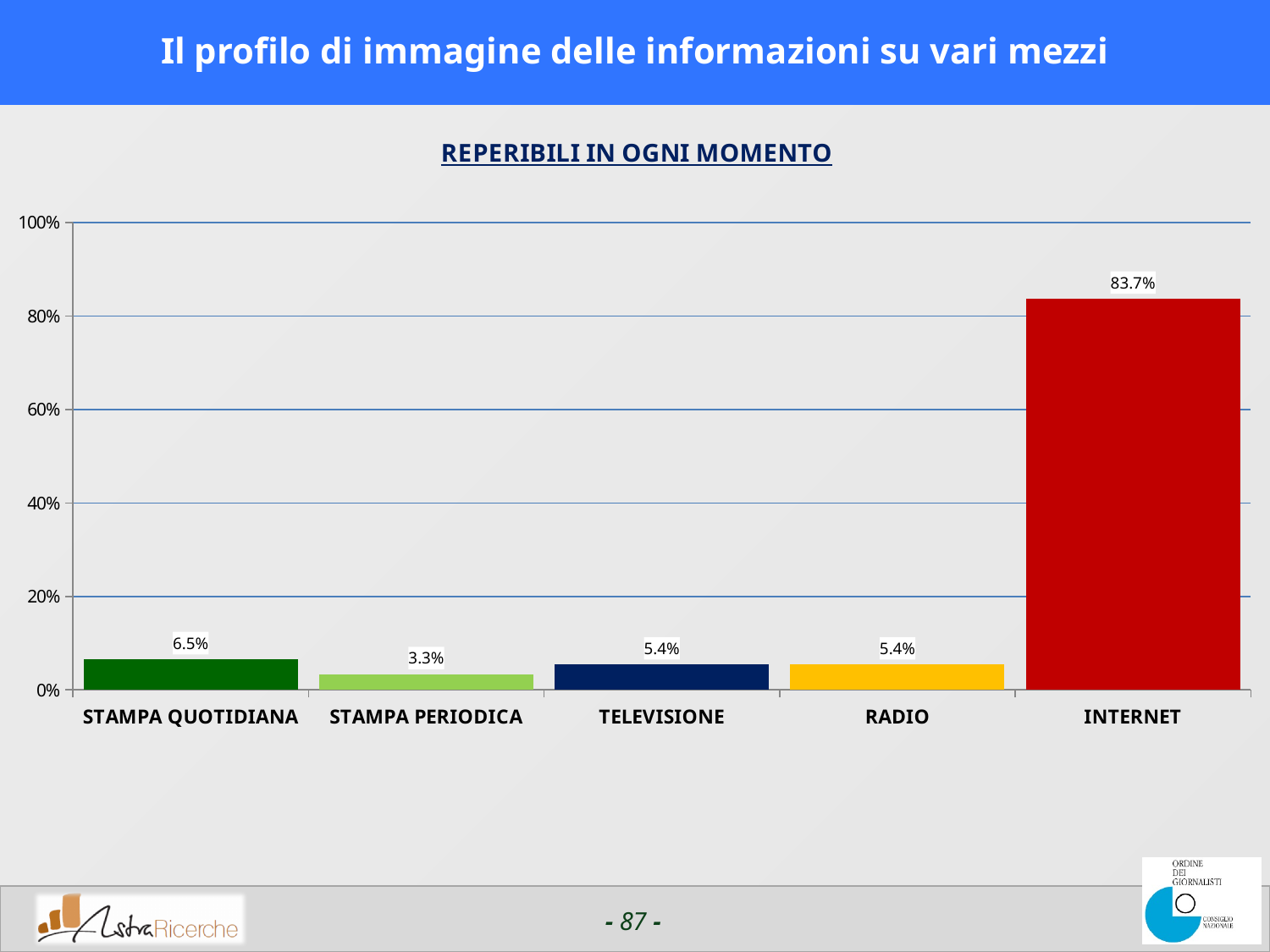
Which is larger, the value for STAMPA QUOTIDIANA or the value for TELEVISIONE? STAMPA QUOTIDIANA Which category has the lowest value? STAMPA PERIODICA What is the difference between the values for INTERNET and STAMPA QUOTIDIANA? 77.2% Is the value for INTERNET greater or less than 80%? greater What is the value for INTERNET? 83.7% What is the difference between the values for STAMPA QUOTIDIANA and STAMPA PERIODICA? 3.2% How many categories are shown on the x axis? 5 Which category has the highest value? INTERNET What is the value for STAMPA PERIODICA? 3.3% What kind of chart is shown on the slide? bar chart What is the value for RADIO? 5.4% What is the value for STAMPA QUOTIDIANA? 6.5%